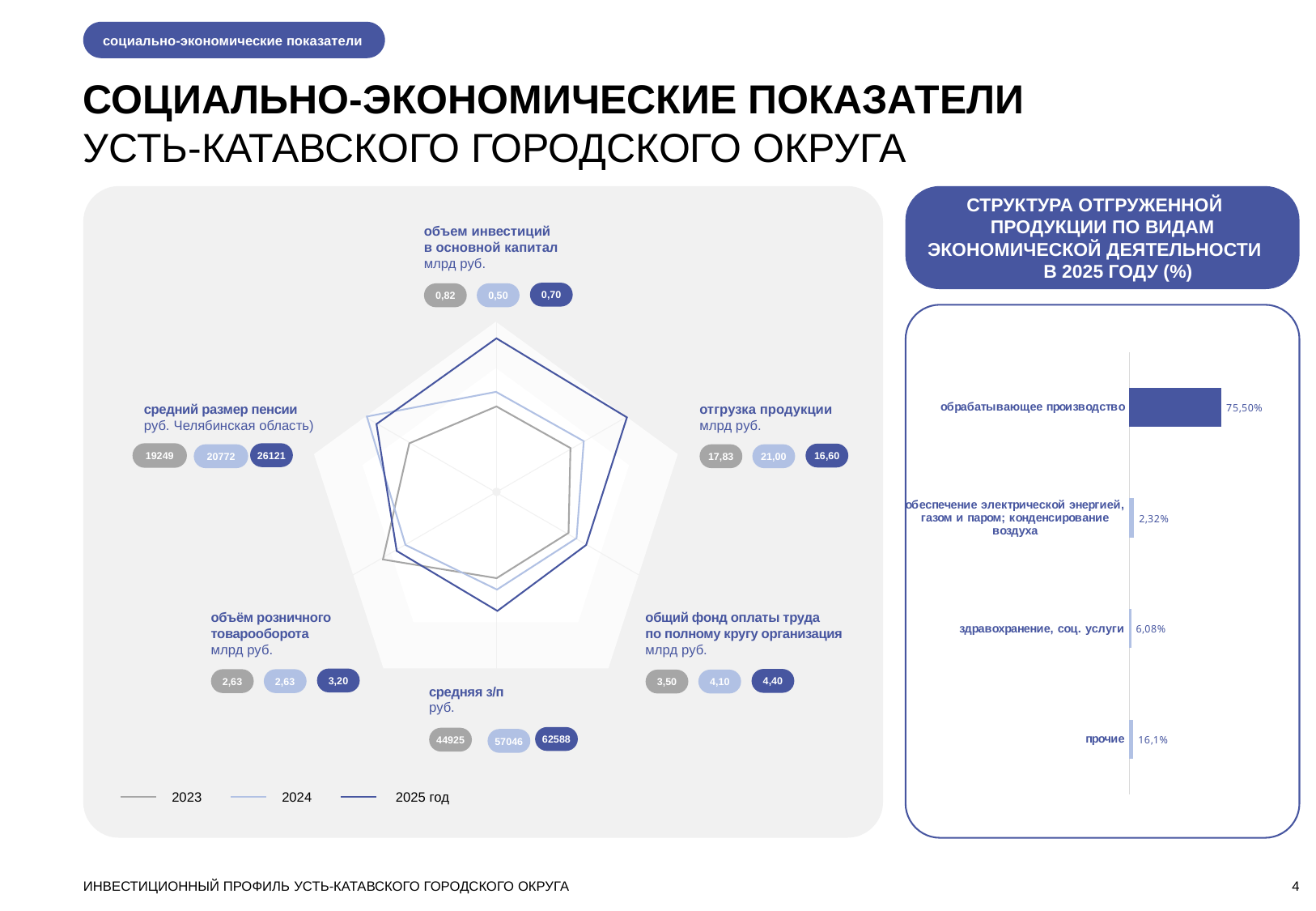
How many axes (indicators) does the radar chart on the left have? 6 In the bar chart on the right, which category has the lowest value? обеспечение электрической энергией, газом и паром; конденсирование воздуха How many categories are shown in the bar chart on the right? 4 In the radar chart on the left, what is the value of отгрузка продукции for 2024? 21,00 In the radar chart on the left, what is the value of средняя з/п for 2025? 62588 What kind of chart is the chart on the left of the slide? radar chart In the bar chart on the right, which category has the highest value? обрабатывающее производство In the bar chart on the right, what is the value for обрабатывающее производство? 75,50% How many series does the legend of the radar chart on the left list? 3 In the bar chart on the right, what is the difference between обрабатывающее производство and прочие? 59,4% In the radar chart on the left, what is the difference between the 2025 and 2023 values of средняя з/п? 17663 In the bar chart on the right, which is larger: здравоохранение, соц. услуги or прочие? прочие